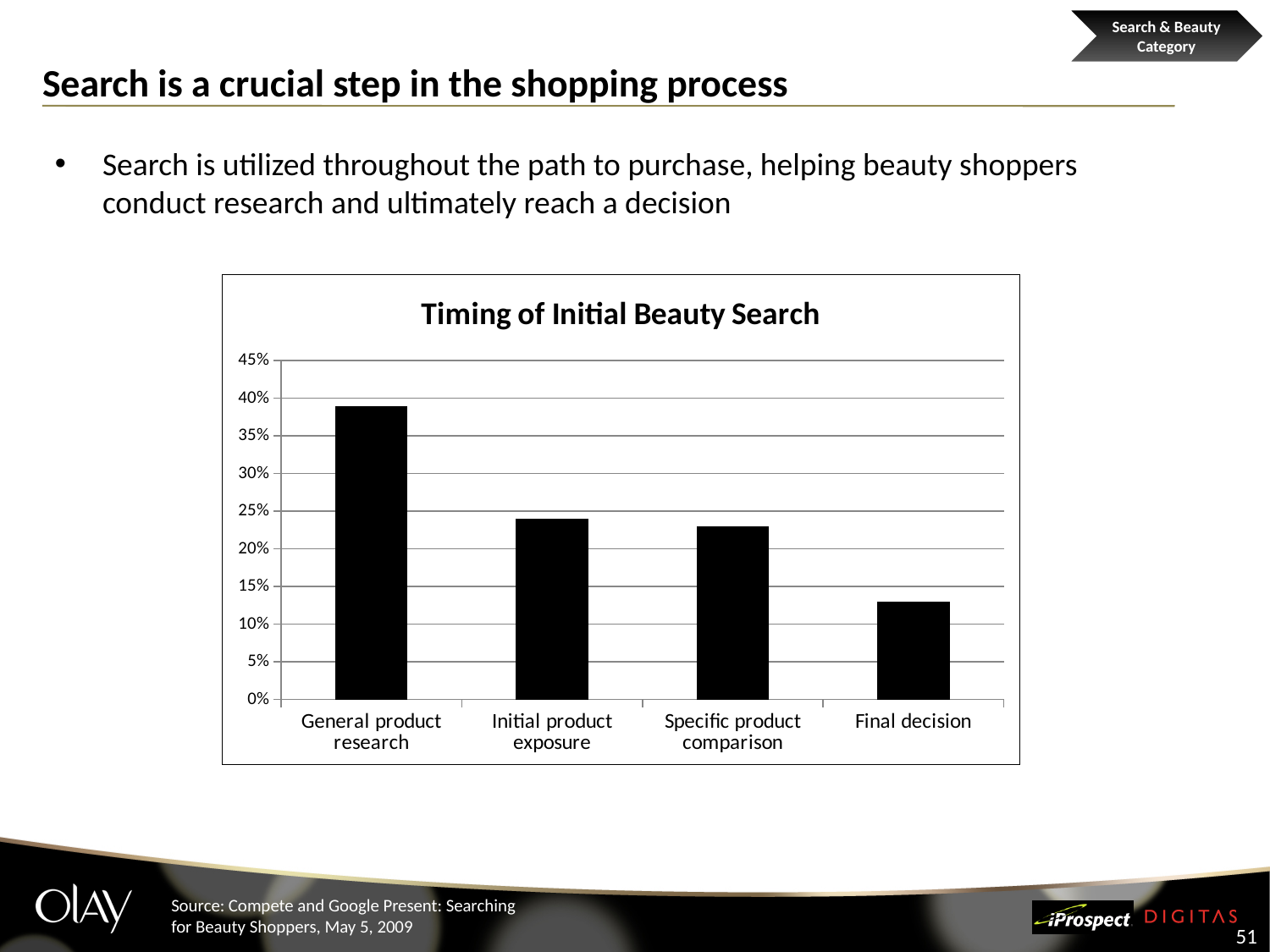
Which is larger, the value for General product research or the value for Final decision? General product research Do the values generally rise or fall moving from left to right along the x axis? fall Is the value for Final decision greater or less than 15%? less What type of chart is shown on the slide? bar chart Which category has the lowest value in the chart? Final decision Is the value for Initial product exposure greater or less than 20%? greater What is the title of the chart? Timing of Initial Beauty Search Which category has the highest value in the chart? General product research Is the value for Specific product comparison greater or less than 25%? less How many categories are shown on the x axis of the chart? 4